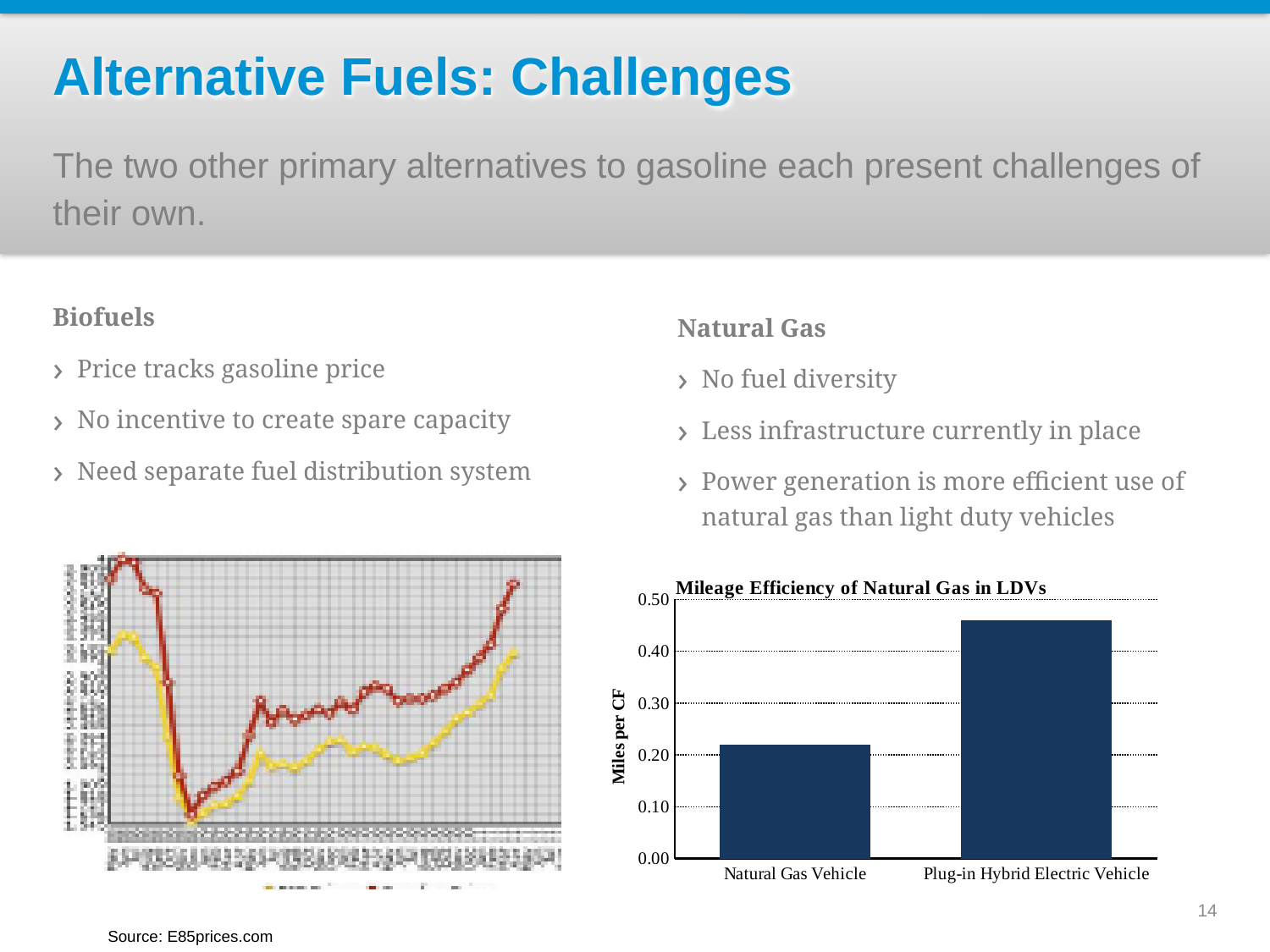
In the chart titled 'Mileage Efficiency of Natural Gas in LDVs', which is larger: the value for Natural Gas Vehicle or the value for Plug-in Hybrid Electric Vehicle? Plug-in Hybrid Electric Vehicle What is the y-axis label of the chart titled 'Mileage Efficiency of Natural Gas in LDVs'? Miles per CF What kind of chart is the chart titled 'Mileage Efficiency of Natural Gas in LDVs'? bar chart What is the title of the bar chart on the right side of the slide? Mileage Efficiency of Natural Gas in LDVs What kind of chart is the chart on the bottom left of the slide? line chart In the chart titled 'Mileage Efficiency of Natural Gas in LDVs', how many categories are plotted? 2 In the chart titled 'Mileage Efficiency of Natural Gas in LDVs', which category has the lowest value? Natural Gas Vehicle In the chart titled 'Mileage Efficiency of Natural Gas in LDVs', is the value for Plug-in Hybrid Electric Vehicle greater or less than 0.50? less In the chart titled 'Mileage Efficiency of Natural Gas in LDVs', is the value for Plug-in Hybrid Electric Vehicle greater or less than 0.40? greater In the chart titled 'Mileage Efficiency of Natural Gas in LDVs', is the value for Natural Gas Vehicle greater or less than 0.10? greater In the chart titled 'Mileage Efficiency of Natural Gas in LDVs', which category has the highest value? Plug-in Hybrid Electric Vehicle